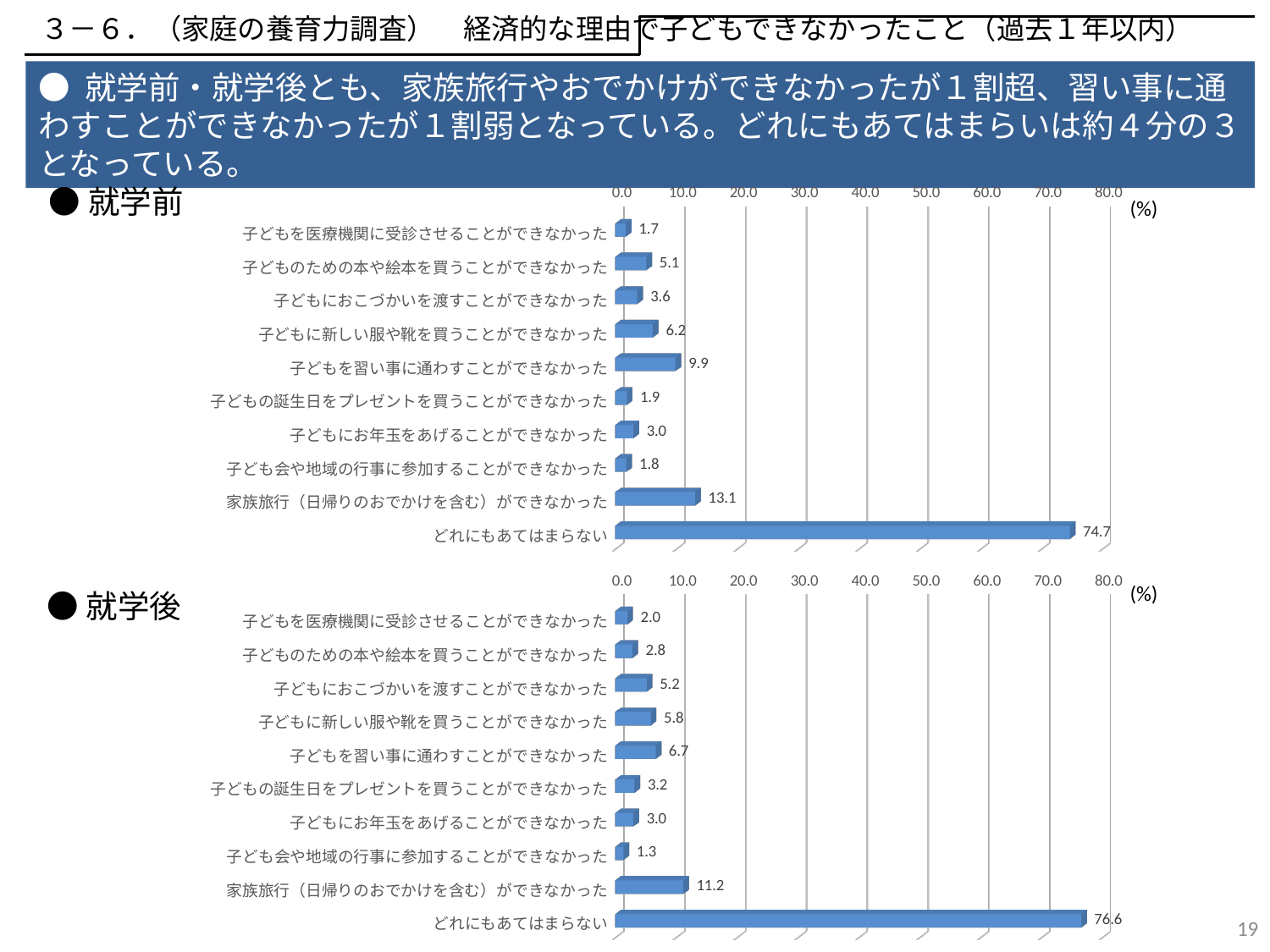
In the 就学前 chart (top), which category has the highest value? どれにもあてはまらない In the 就学後 chart (bottom), what is the difference between どれにもあてはまらない and 家族旅行（日帰りのおでかけを含む）ができなかった? 65.4 In the 就学後 chart (bottom), what is the value for 子どもを習い事に通わすことができなかった? 6.7 In the 就学前 chart (top), what is the value for 家族旅行（日帰りのおでかけを含む）ができなかった? 13.1 In the 就学前 chart (top), what is the value for 子どもを医療機関に受診させることができなかった? 1.7 What unit is shown at the end of the horizontal axis in both charts? (%) How many categories are shown in the 就学後 chart (bottom)? 10 In the 就学後 chart (bottom), which is larger: 子どもにおこづかいを渡すことができなかった or 子どものための本や絵本を買うことができなかった? 子どもにおこづかいを渡すことができなかった In the 就学後 chart (bottom), which category has the lowest value? 子ども会や地域の行事に参加することができなかった In the 就学前 chart (top), is the value for どれにもあてはまらない greater or less than 70.0? greater What type of chart is the 就学前 chart (top)? Bar chart In the 就学前 chart (top), what is the difference between どれにもあてはまらない and 家族旅行（日帰りのおでかけを含む）ができなかった? 61.6